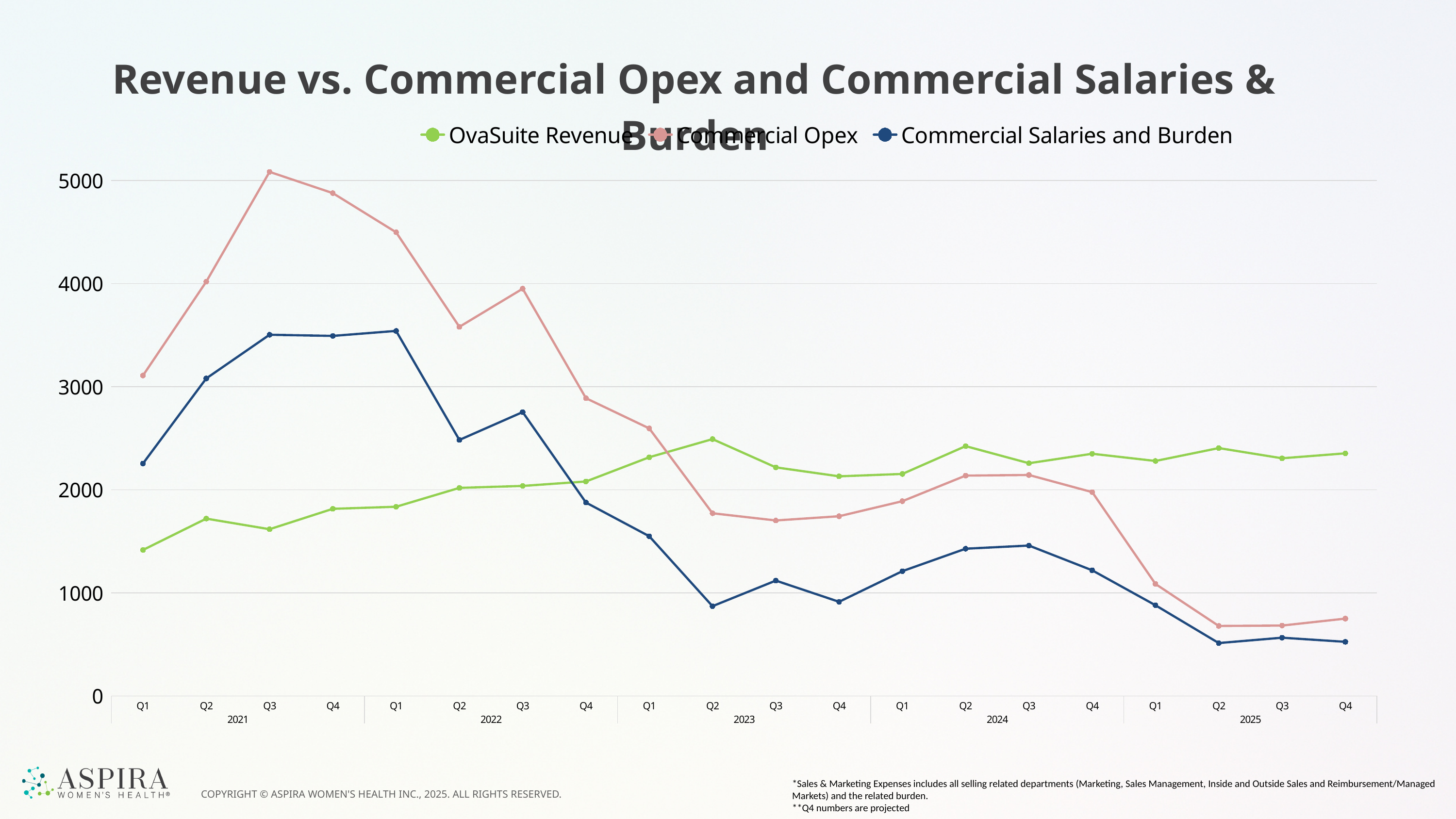
Is the value for Commercial Opex in Q3 2021 greater or less than 4000? greater In which quarter does Commercial Opex reach its highest value? Q3 2021 Which series is drawn in green? OvaSuite Revenue How many quarterly points are plotted along the x axis? 20 What kind of chart is shown on the slide? Line chart Does Commercial Opex generally rise or fall from Q3 2021 to Q4 2025? Fall Is the value for Commercial Opex in Q4 2025 greater or less than 1000? less Is the value for Commercial Salaries and Burden in Q1 2021 greater or less than 2000? greater In which quarter is OvaSuite Revenue at its lowest? Q1 2021 How many series does the legend list? 3 In Q1 2021, which is larger: Commercial Opex or OvaSuite Revenue? Commercial Opex